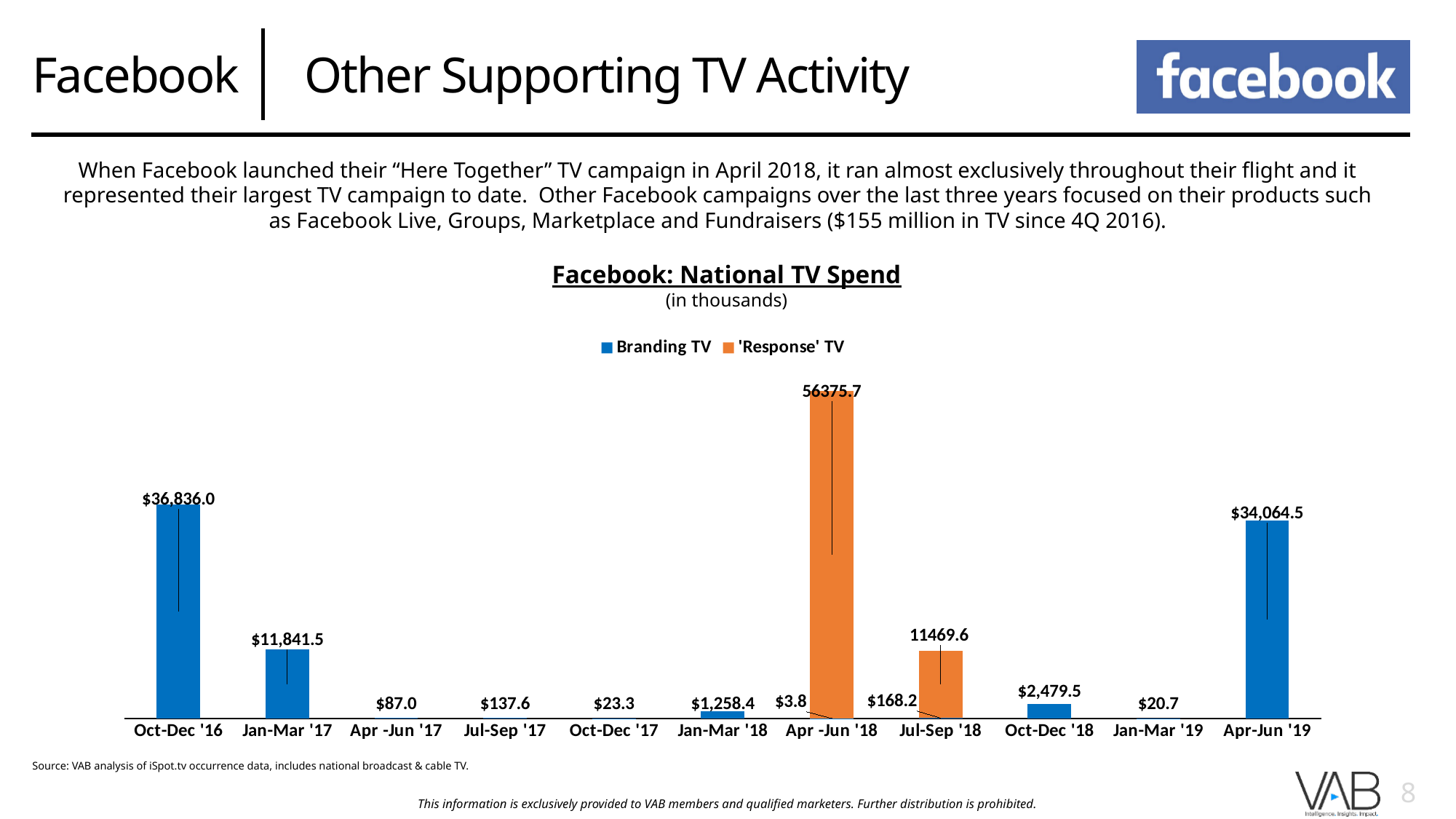
What is the Branding TV spend for Oct-Dec '16? $36,836.0 What is the 'Response' TV spend for Jul-Sep '18? 11469.6 Which quarter has the larger Branding TV spend, Jan-Mar '17 or Oct-Dec '18? Jan-Mar '17 How much higher is the Branding TV spend in Oct-Dec '16 than in Apr-Jun '19? $2,771.5 How many quarters are shown on the x axis of the chart? 11 What is the Branding TV spend for Apr-Jun '19? $34,064.5 What type of chart is used to show Facebook's National TV Spend? Bar chart Which quarter has the lowest Branding TV spend? Apr-Jun '18 How many series does the chart's legend list? 2 What is the Branding TV spend for Jan-Mar '18? $1,258.4 Which quarter has the highest Branding TV spend? Oct-Dec '16 What is the 'Response' TV spend for Apr-Jun '18? 56375.7